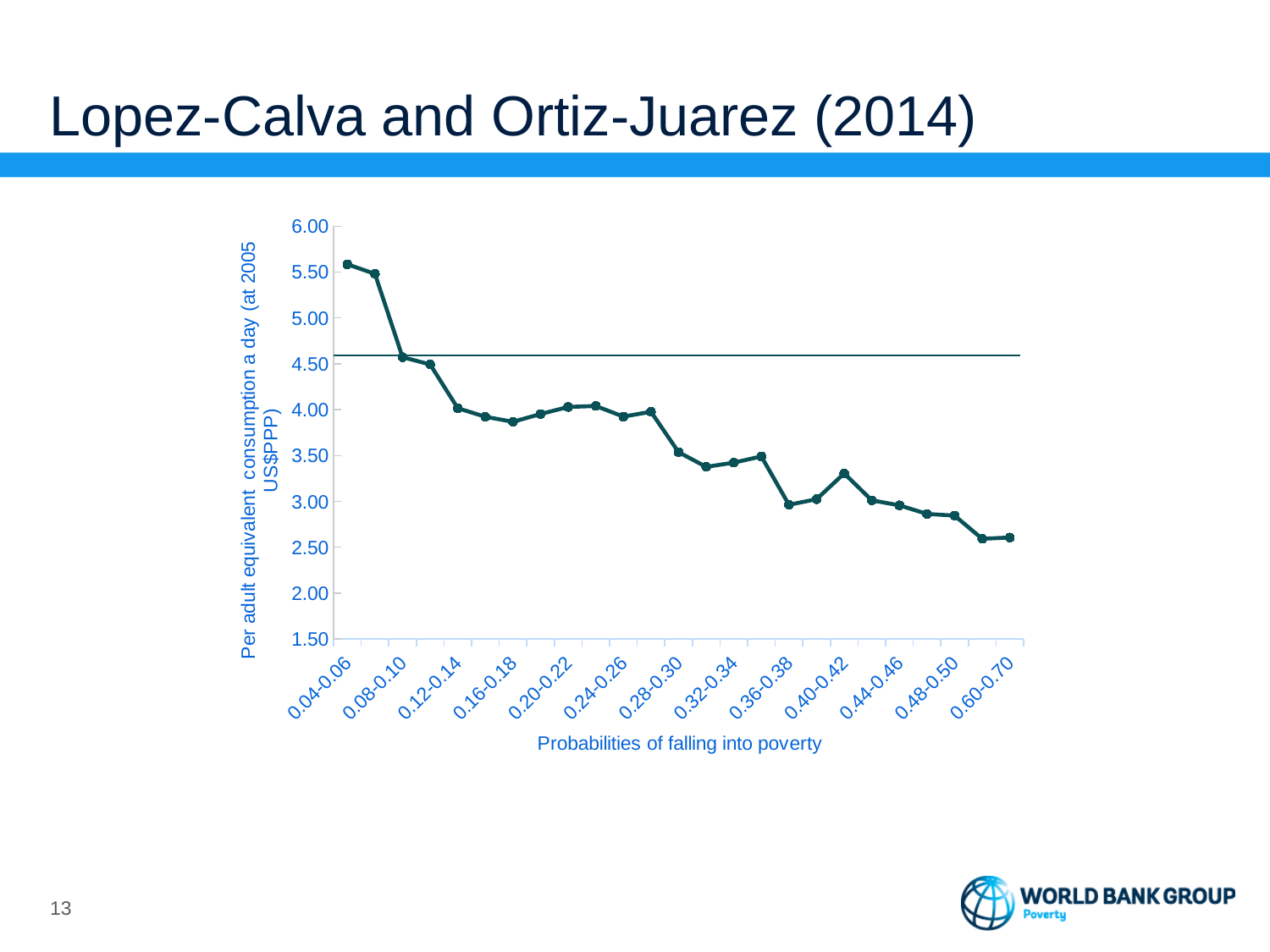
Which has the larger value, 0.12-0.14 or 0.28-0.30? 0.12-0.14 Is the value for 0.36-0.38 greater or less than 3.50? less Is the value for 0.60-0.70 greater or less than 3.00? less Is the value for 0.40-0.42 greater or less than 3.00? greater What is the title of the x axis? Probabilities of falling into poverty Do the values generally rise or fall as the probability of falling into poverty increases along the x axis? fall What kind of chart is shown on the slide? line chart Which has the larger value, 0.04-0.06 or 0.60-0.70? 0.04-0.06 How many probability-range labels are printed along the x axis? 13 Which probability range has the highest per adult equivalent consumption? 0.04-0.06